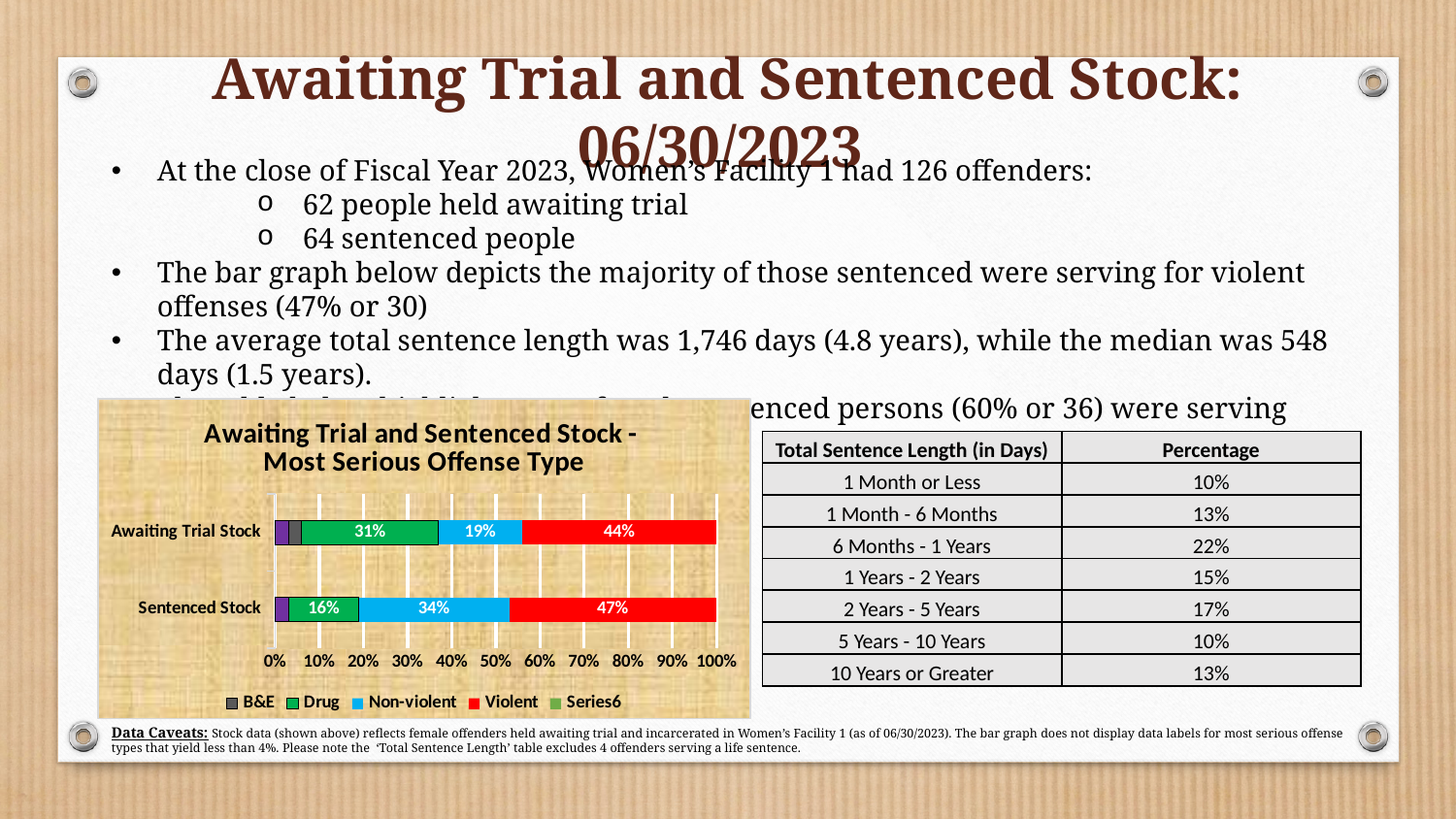
What kind of chart is shown on the slide? Stacked bar chart What is the Violent share for the Sentenced Stock bar? 47% Which offense type has the largest share in the Sentenced Stock bar? Violent What is the Drug share for the Awaiting Trial Stock bar? 31% What is the Non-violent share for the Sentenced Stock bar? 34% What is the Drug share for the Sentenced Stock bar? 16% What is the difference between the Violent share for Sentenced Stock and the Violent share for Awaiting Trial Stock? 3 percentage points How many series does the chart legend list? 5 How many categories (bars) does the chart show? 2 What is the Violent share for the Awaiting Trial Stock bar? 44% Which bar has the larger Non-violent share, Awaiting Trial Stock or Sentenced Stock? Sentenced Stock What is the title of the chart? Awaiting Trial and Sentenced Stock - Most Serious Offense Type